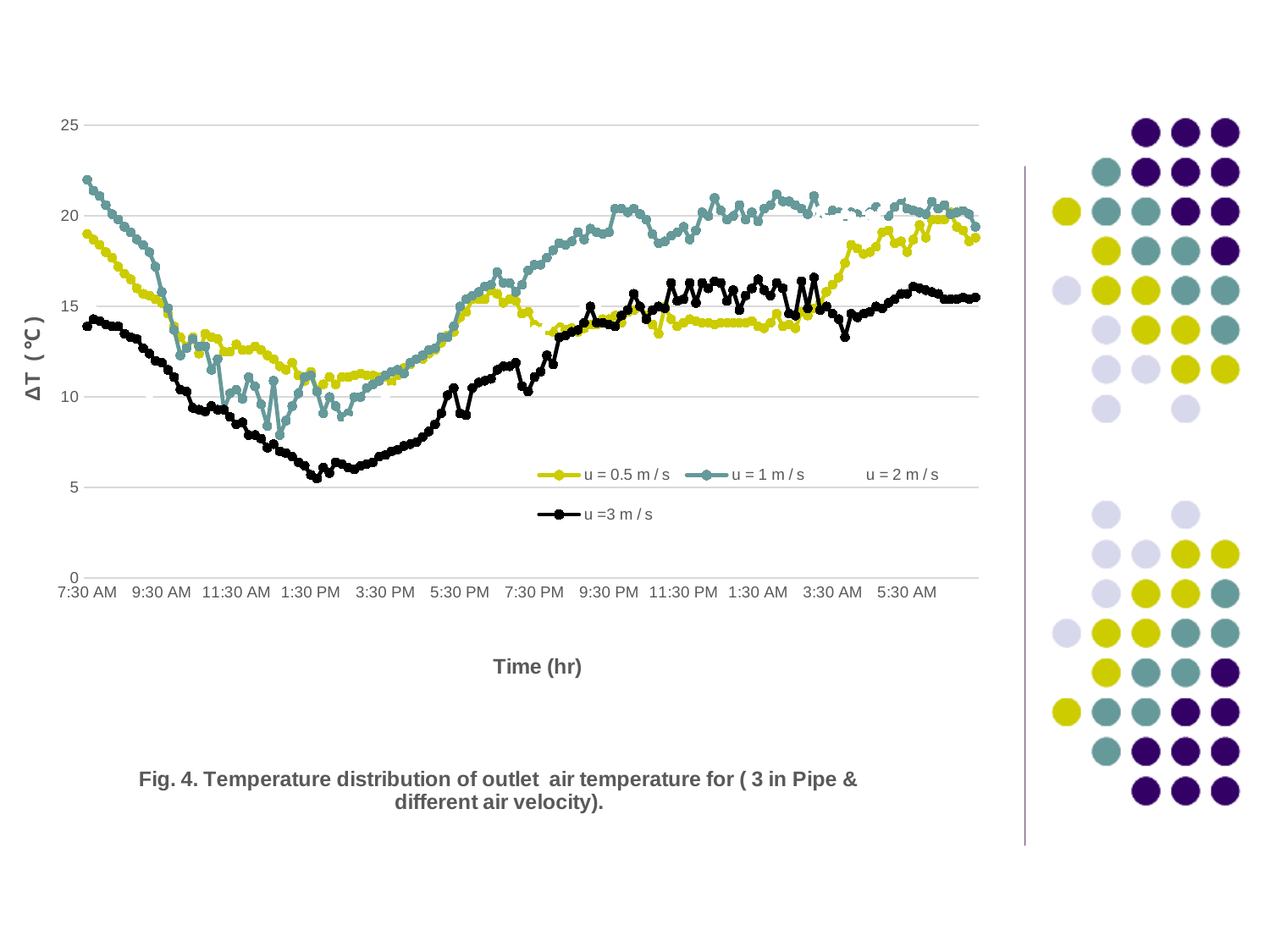
Is the value for u = 3 m/s at 3:30 PM greater or less than 10? less Is the value for u = 1 m/s at 7:30 AM greater or less than 20? greater At 7:30 AM, which is higher: u = 1 m/s or u = 0.5 m/s? u = 1 m/s Is the value for u = 0.5 m/s at 11:30 PM greater or less than 15? less Which series has the lowest value at 1:30 PM? u = 3 m/s What is the label of the y axis? ΔT (°C) Does the u = 3 m/s series rise or fall between 7:30 AM and 1:30 PM? fall What kind of chart is shown on the slide? line chart At 11:30 PM, which is higher: u = 1 m/s or u = 3 m/s? u = 1 m/s What is the label of the x axis? Time (hr) How many series does the legend list? 4